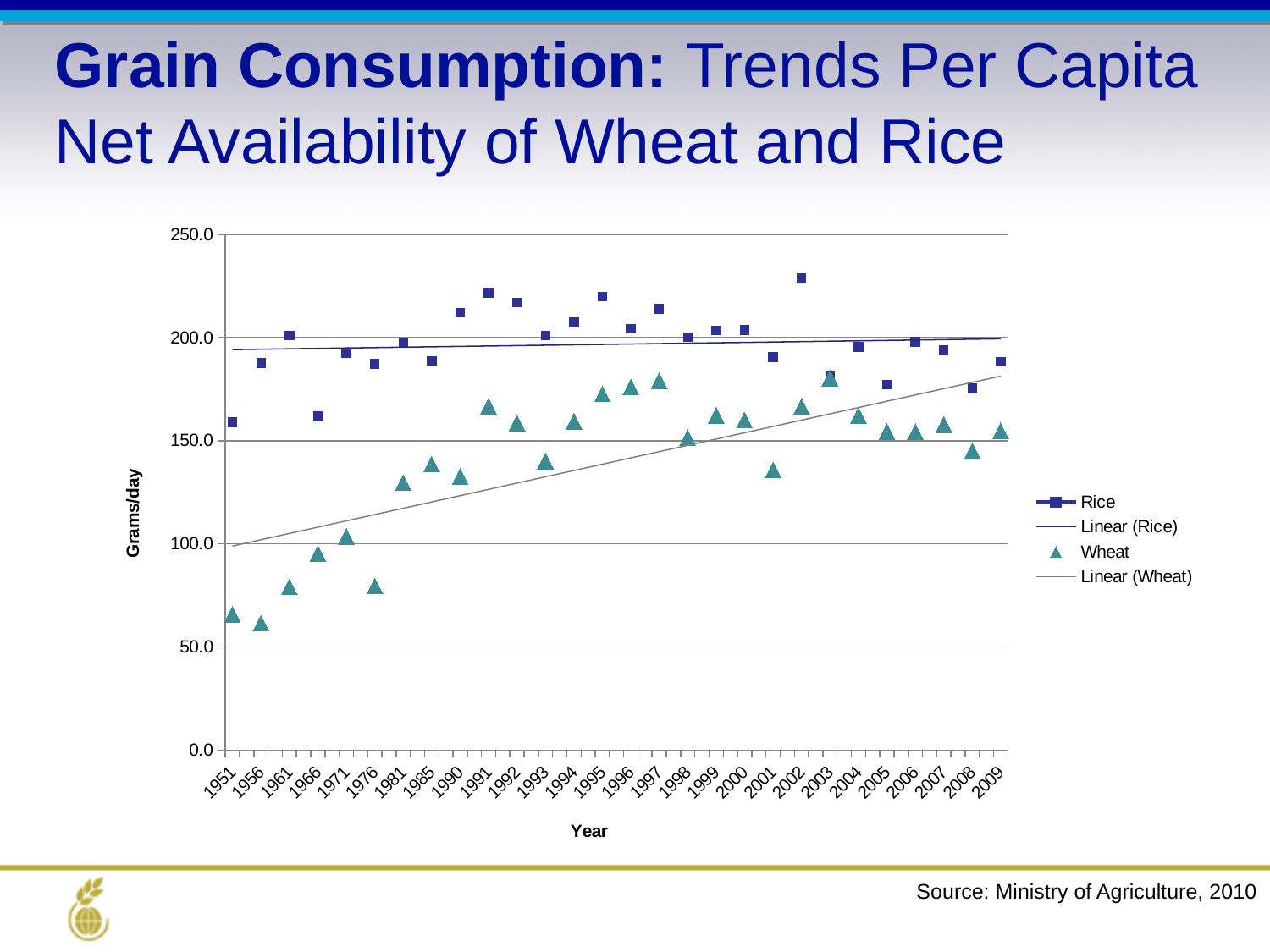
Is the Wheat value for 1976 greater or less than 100? less Is the Wheat value for 2001 greater or less than 150? less Is the Rice value for 1951 greater or less than 150? greater How many series does the legend list? 4 In which year is the Rice value highest? 2002 What is the label of the y axis? Grams/day How many years are plotted along the x axis? 28 What is the label of the x axis? Year Does the Wheat series generally rise or fall from 1951 to 2009? rise In 1951, which is larger, the Rice value or the Wheat value? Rice